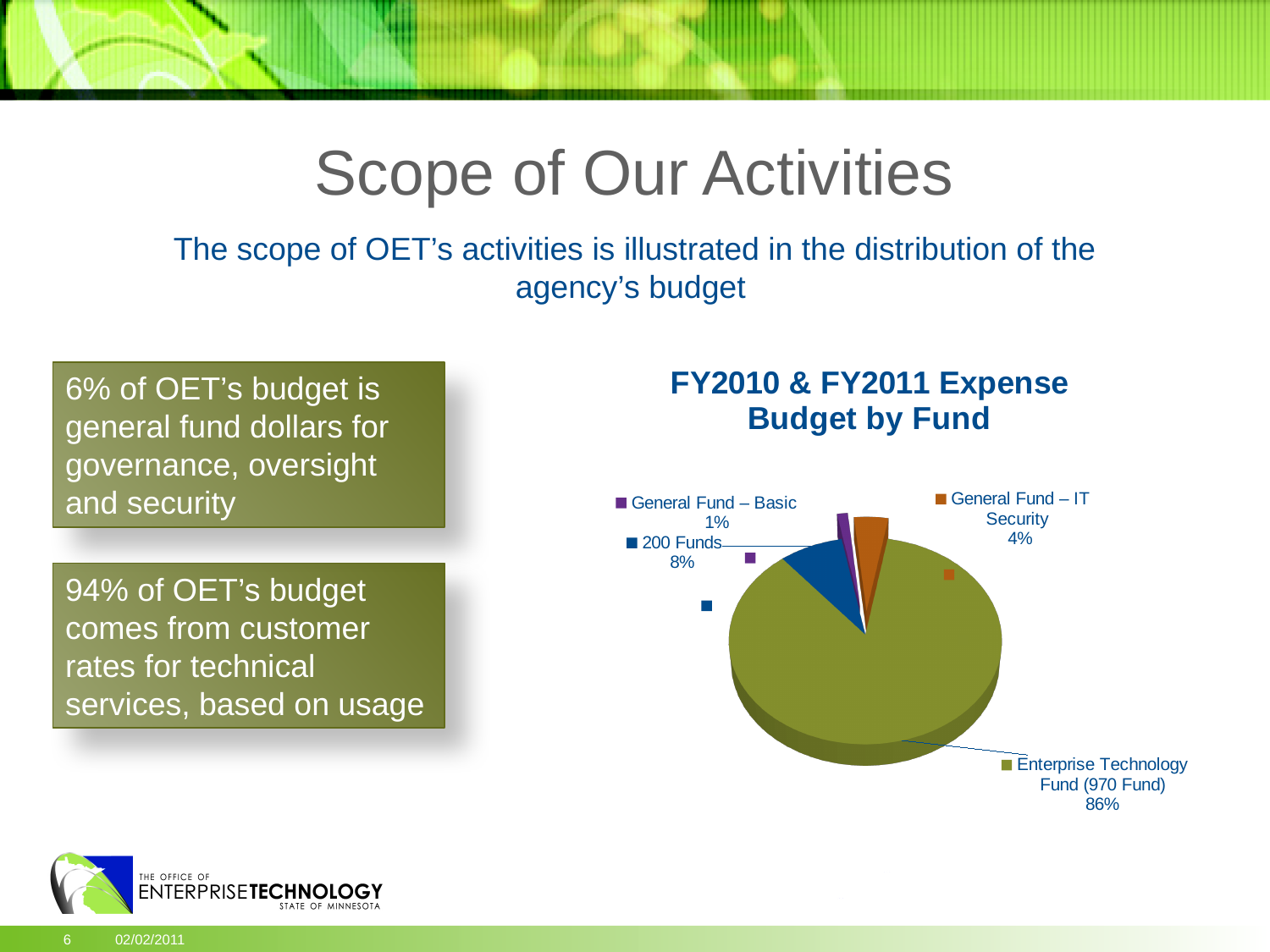
What is the difference in percentage points between the 200 Funds share and the General Fund – IT Security share? 4% What share of the budget does the Enterprise Technology Fund (970 Fund) represent? 86% Which fund has the largest share of the budget? Enterprise Technology Fund (970 Fund) How many slices does the pie chart have? 4 What is the difference in percentage points between the Enterprise Technology Fund (970 Fund) share and the 200 Funds share? 78% Which fund has the smallest share of the budget? General Fund – Basic What share of the budget does General Fund – Basic represent? 1% What is the title of the chart? FY2010 & FY2011 Expense Budget by Fund What share of the budget does General Fund – IT Security represent? 4% What kind of chart is shown on the slide? Pie chart Which is larger, the share for 200 Funds or the share for General Fund – IT Security? 200 Funds